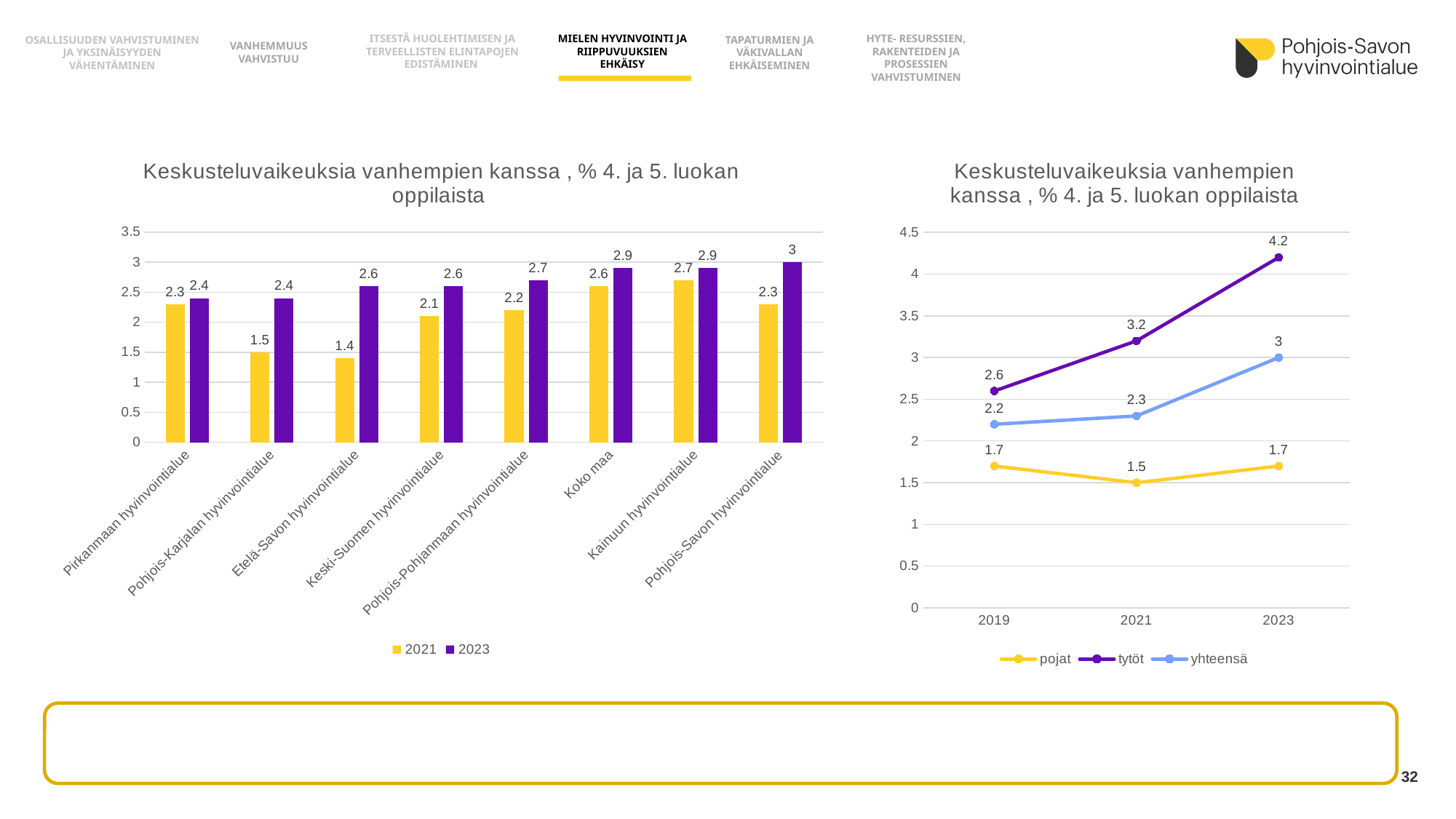
In the bar chart on the left, which category has the lowest 2021 value? Etelä-Savon hyvinvointialue In the bar chart on the left, what is the difference between the 2023 and 2021 values for Pohjois-Karjalan hyvinvointialue? 0.9 In the line chart on the right, what is the value for tytöt in 2023? 4.2 In the line chart on the right, which is larger in 2019: the value for tytöt or the value for pojat? tytöt In the bar chart on the left, what is the 2021 value for Etelä-Savon hyvinvointialue? 1.4 In the bar chart on the left, what is the 2023 value for Pohjois-Savon hyvinvointialue? 3 In the bar chart on the left, how many series does the legend list? 2 What kind of chart is the chart on the right? Line chart In the line chart on the right, does the tytöt series rise or fall from 2019 to 2023? Rise In the line chart on the right, what is the value for yhteensä in 2021? 2.3 In the bar chart on the left, which category has the highest 2023 value? Pohjois-Savon hyvinvointialue In the bar chart on the left, how many categories are shown on the x axis? 8